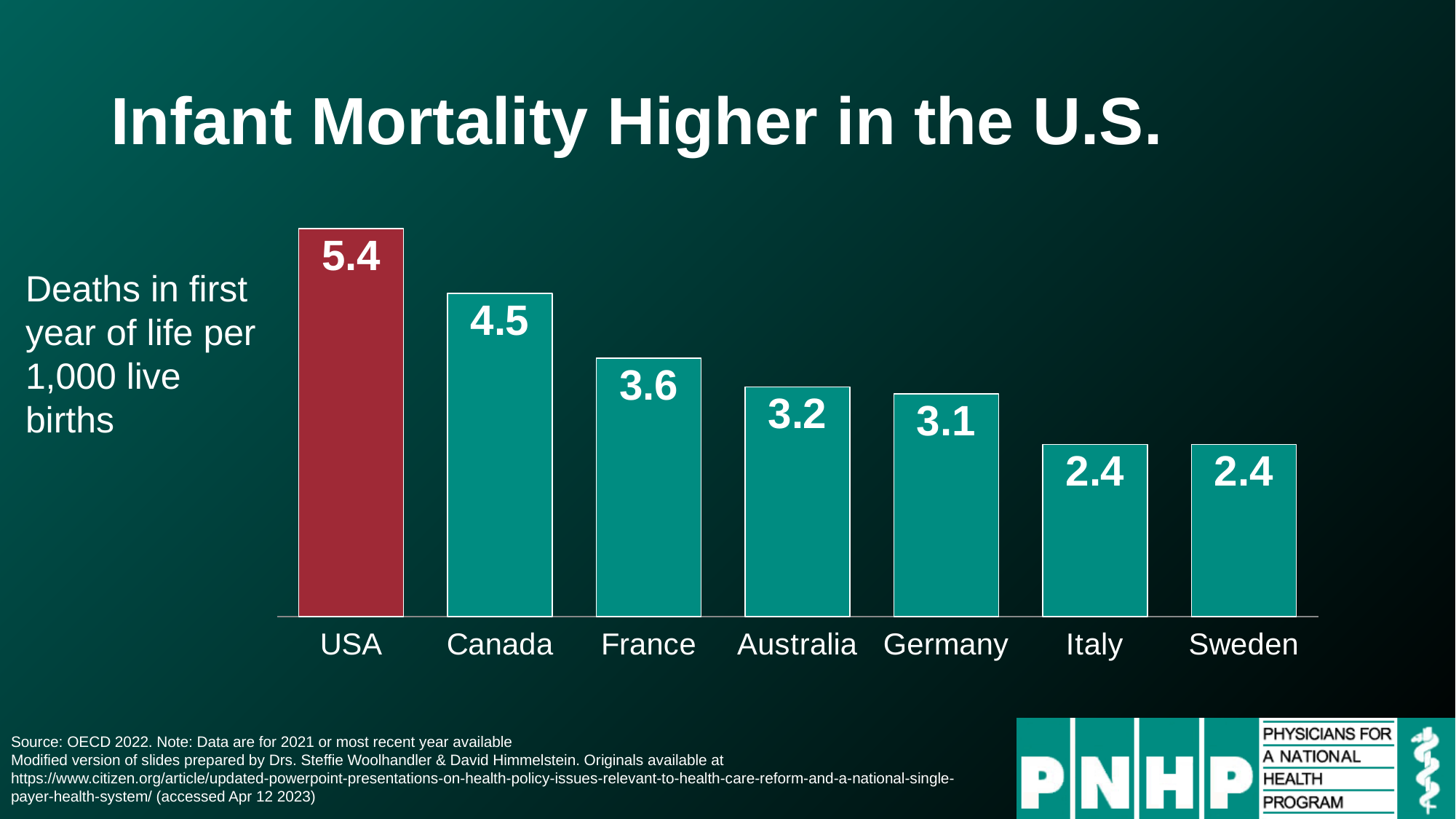
What is the title of the slide? Infant Mortality Higher in the U.S. Which country has the highest infant mortality on the chart? USA What is the infant mortality value shown for Germany? 3.1 What is the difference between the USA value and the Canada value? 0.9 Which country's bar is coloured red rather than teal? USA What is the infant mortality value shown for the USA? 5.4 What is the difference between the France value and the Sweden value? 1.2 How many countries are shown on the chart? 7 Do the values rise or fall moving from left to right across the chart? Fall What kind of chart is shown on the slide? Bar chart Which has a higher value, France or Australia? France What is the infant mortality value shown for Canada? 4.5